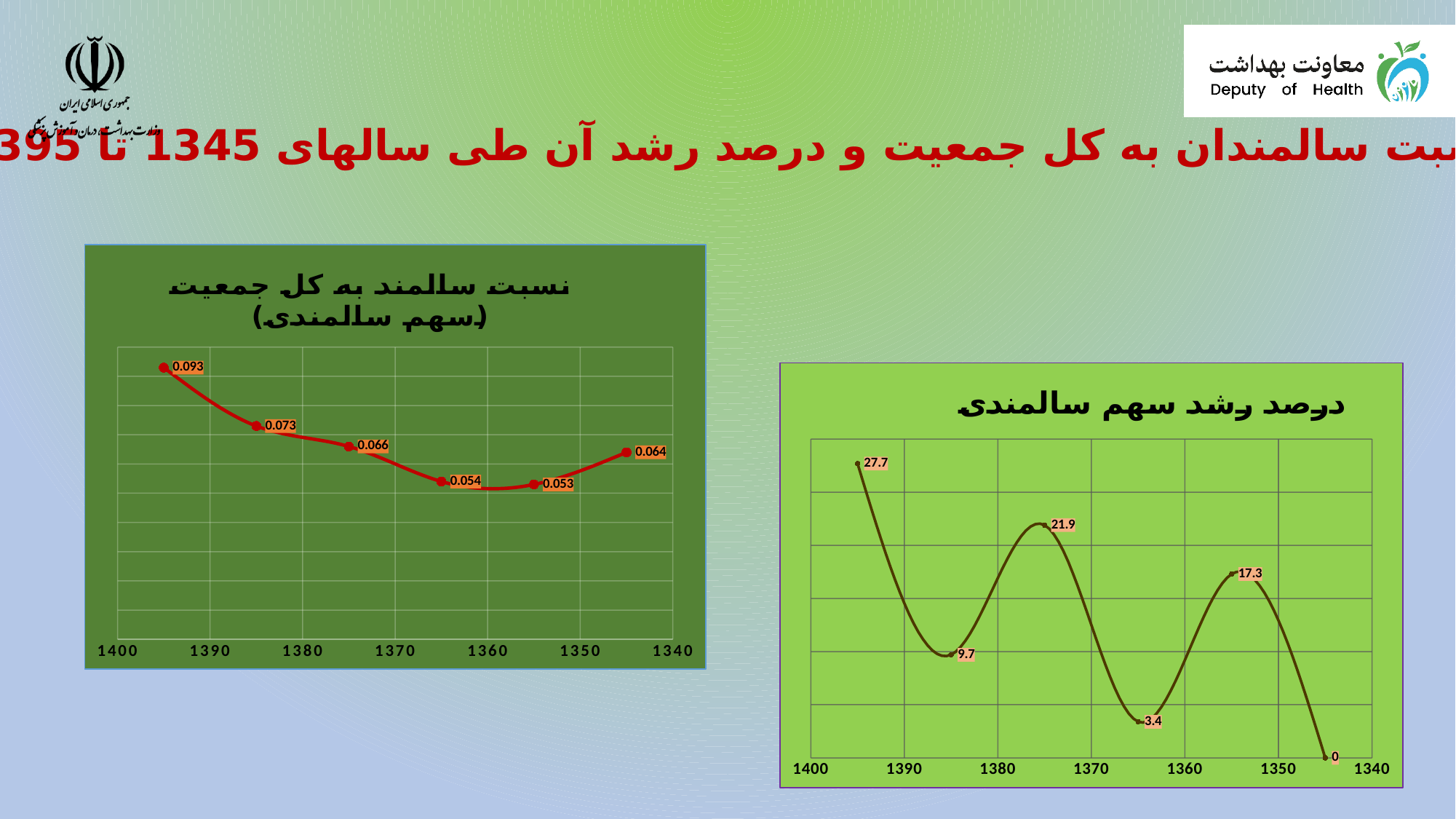
On the right chart 'درصد رشد سهم سالمندی', what is the highest labelled value? 27.7 On the right chart 'درصد رشد سهم سالمندی', which is larger: the point between 1390 and 1380 or the point between 1370 and 1360? the point between 1390 and 1380 (9.7) On the right chart 'درصد رشد سهم سالمندی', what is the difference between the values 21.9 and 17.3? 4.6 What kind of chart is the left chart titled 'نسبت سالمند به کل جمعیت (سهم سالمندی)'? line chart On the left chart 'نسبت سالمند به کل جمعیت', what is the difference between the leftmost point (0.093) and the rightmost point (0.064)? 0.029 How many data points are plotted on the left chart 'نسبت سالمند به کل جمعیت'? 6 On the right chart 'درصد رشد سهم سالمندی', what is the lowest labelled value? 0 What colour is the line on the left chart 'نسبت سالمند به کل جمعیت'? red On the left chart 'نسبت سالمند به کل جمعیت', what is the value of the point between the 1390 and 1380 ticks? 0.073 On the right chart 'درصد رشد سهم سالمندی', what is the value of the point between the 1390 and 1380 ticks? 9.7 On the left chart 'نسبت سالمند به کل جمعیت', what is the highest labelled value? 0.093 On the left chart 'نسبت سالمند به کل جمعیت', what is the lowest labelled value? 0.053